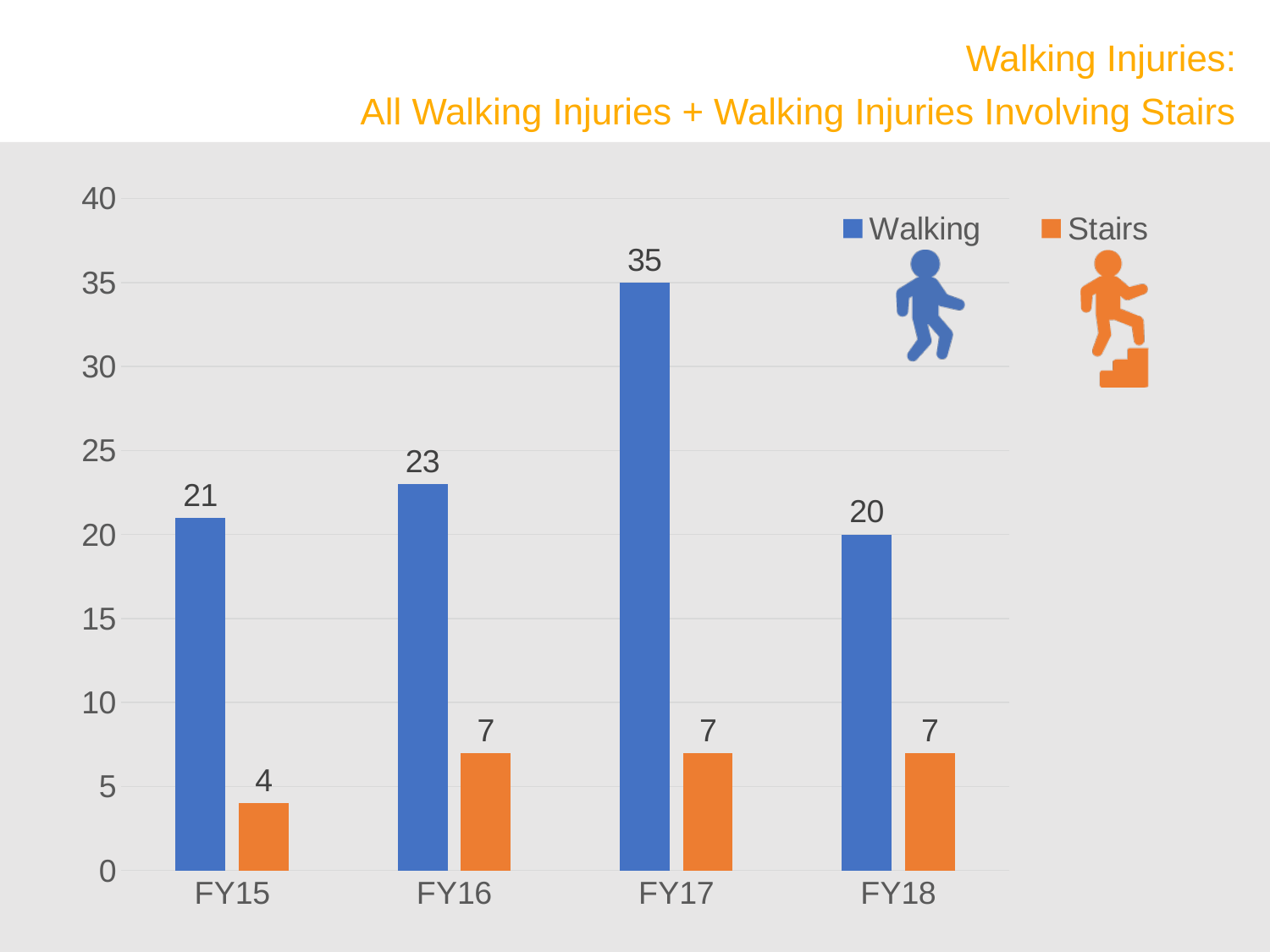
Which is larger, the Walking value for FY15 or the Walking value for FY16? FY16 What is the Stairs value for FY15? 4 Which fiscal year has the highest Walking value? FY17 How many series does the legend list? 2 Which fiscal year has the lowest Stairs value? FY15 What colour are the Stairs bars? Orange Is the Walking value for FY17 greater or less than 30? greater What kind of chart is shown on the slide? Bar chart What is the difference between the Walking values for FY17 and FY16? 12 What is the Walking value for FY17? 35 What is the Walking value for FY18? 20 How many fiscal years are shown on the x axis? 4